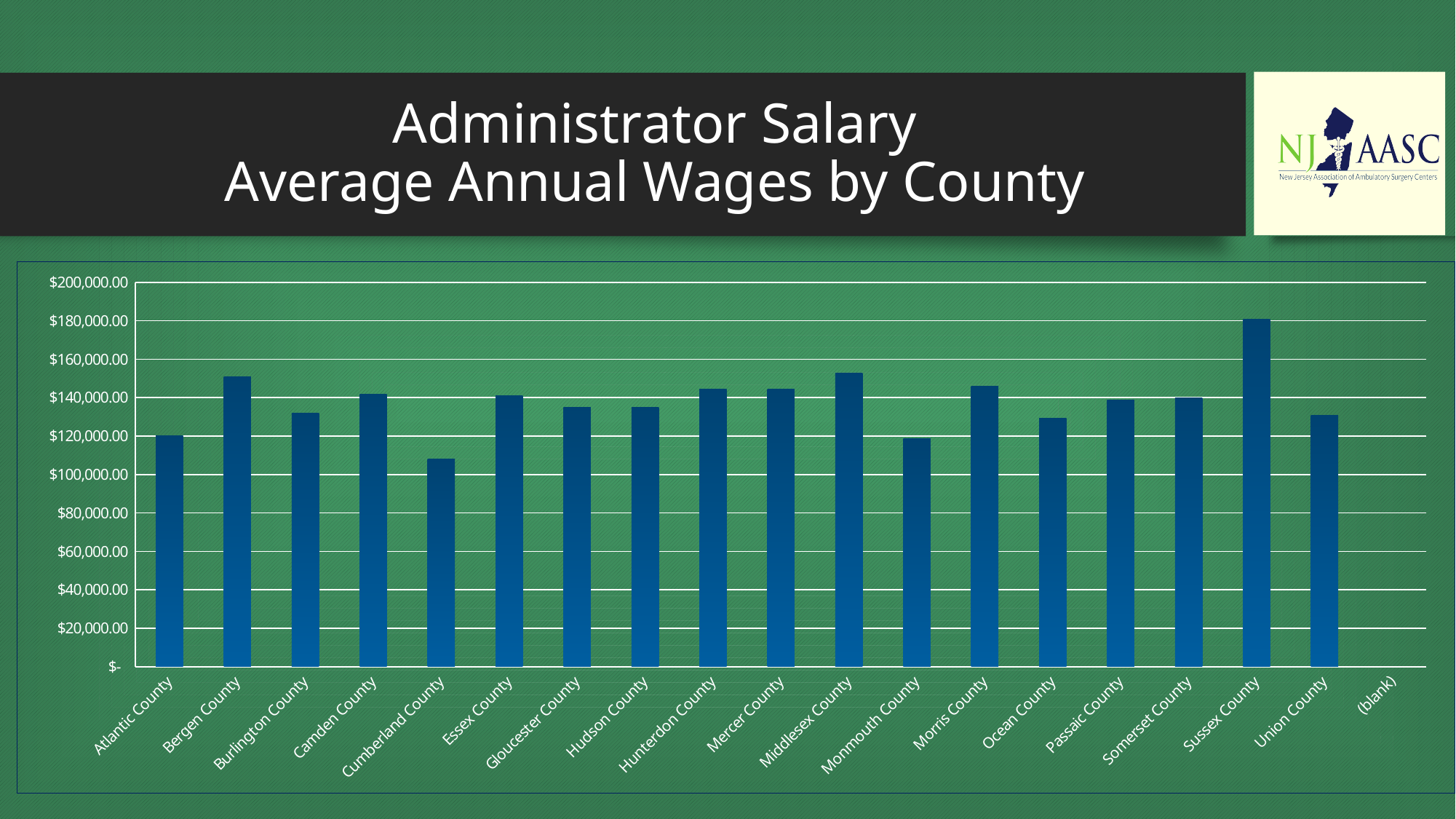
Is the value for Sussex County greater or less than $160,000.00? greater What kind of chart is shown on the slide? bar chart Is the value for Burlington County greater or less than $120,000.00? greater Which has a higher average annual wage, Sussex County or Bergen County? Sussex County What is the highest tick value shown on the y axis? $200,000.00 Which county has the lowest average annual administrator wage? Cumberland County Is the value for Cumberland County greater or less than $120,000.00? less Which has a higher average annual wage, Morris County or Ocean County? Morris County Which county has the highest average annual administrator wage? Sussex County How many counties have a bar plotted on the chart? 18